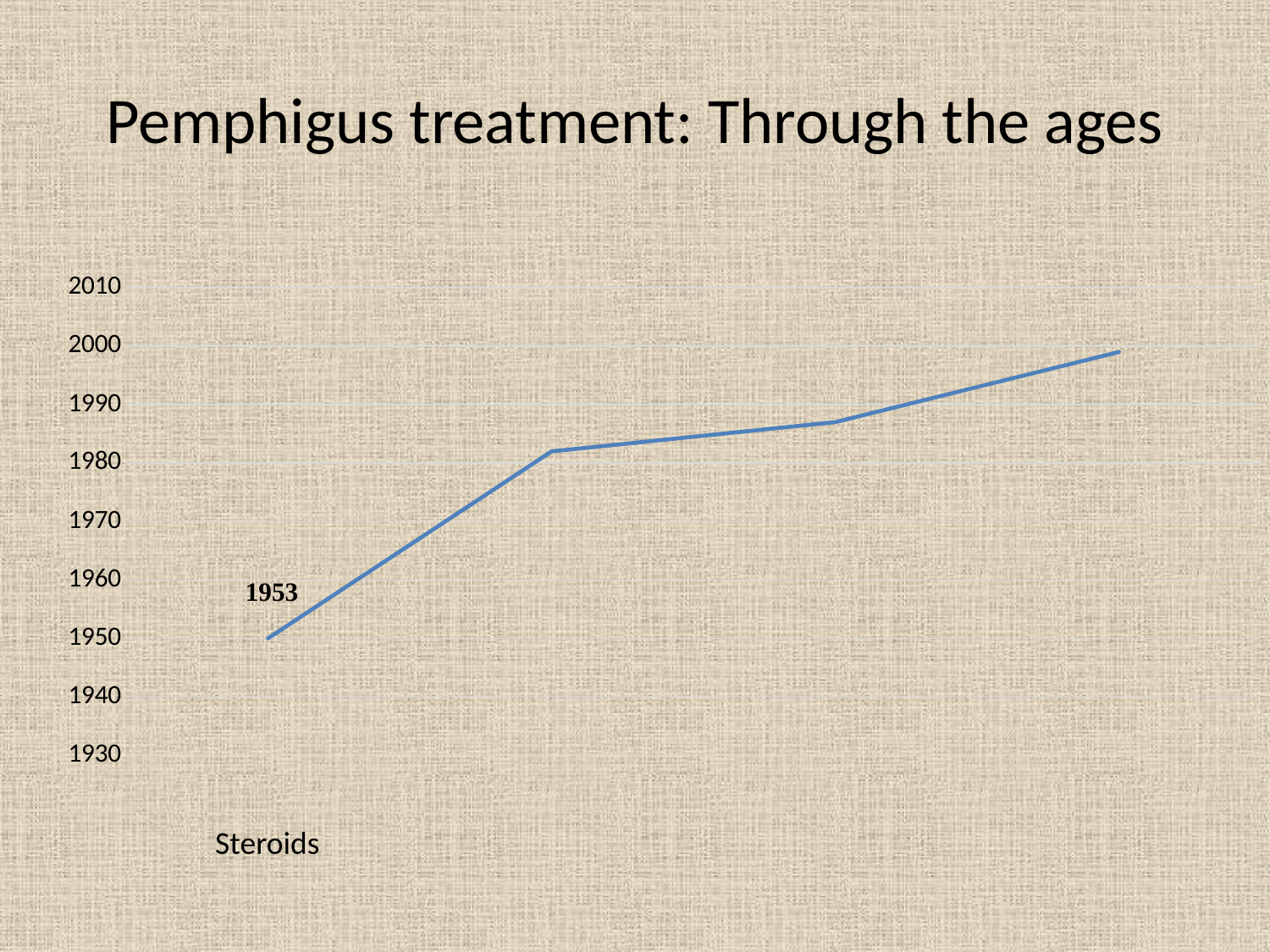
Is the value for Steroids greater or less than 1960? less What is the title of the chart? Pemphigus treatment: Through the ages How many data points are plotted on the line? 4 What kind of chart is shown on the slide? line chart Is the value of the rightmost point on the line greater or less than 1990? greater Is the value for Steroids greater or less than 1940? greater Do the values rise or fall from left to right along the x axis? rise Which point on the line is the lowest? Steroids What value is labelled on the data point for Steroids? 1953 What is the lowest value shown on the y axis? 1930